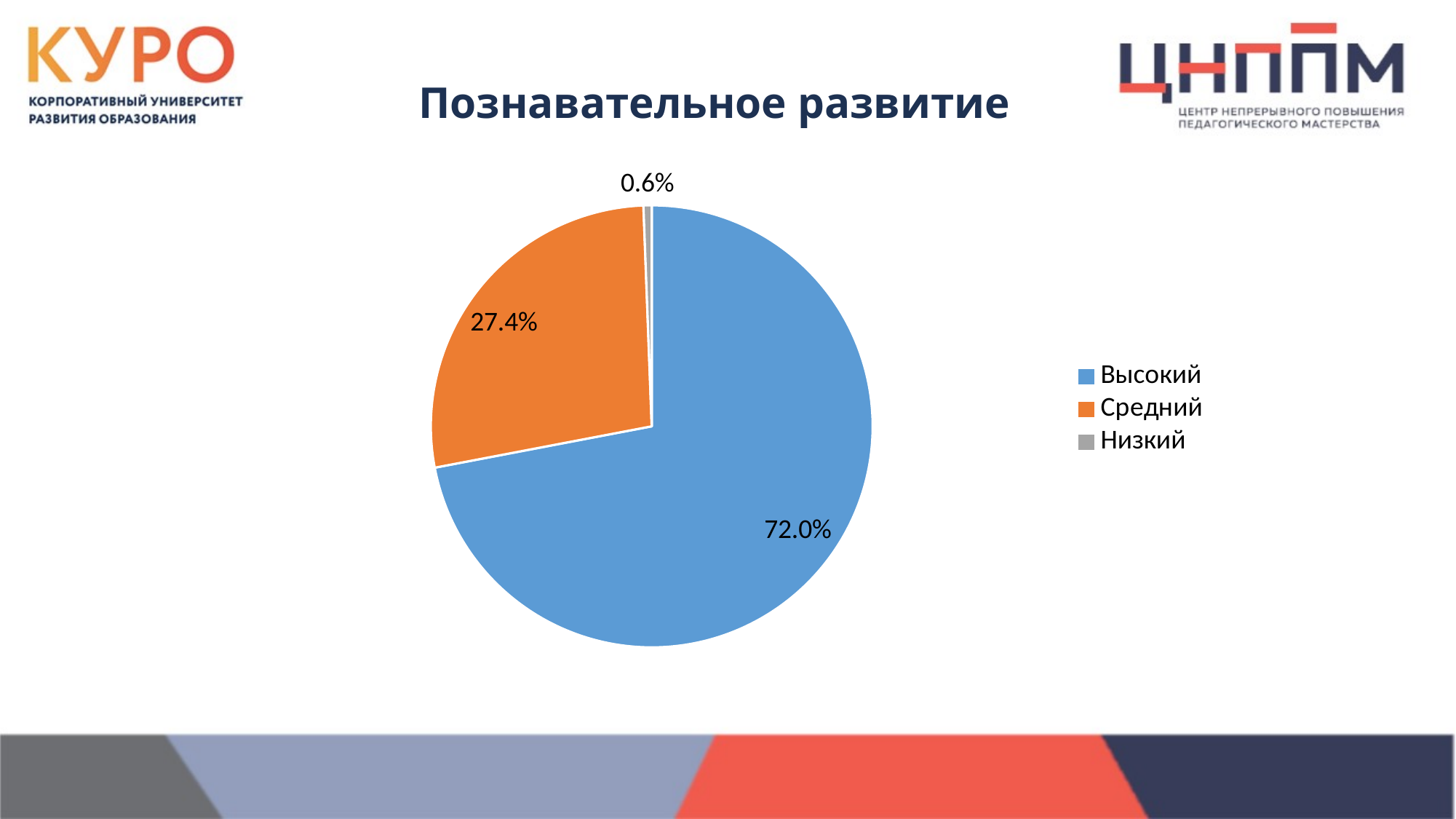
What is the value for Высокий? 72.0% What is the title of the chart? Познавательное развитие What is the value for Низкий? 0.6% What type of chart is shown on the slide? pie chart What colour is the slice for Средний? orange Which category has the smallest share of the pie? Низкий What is the value for Средний? 27.4% How many slices does the pie chart have? 3 How many entries does the legend list? 3 What is the difference between the values for Высокий and Средний? 44.6% Which category has the largest share of the pie? Высокий Which is larger, the value for Средний or the value for Низкий? Средний